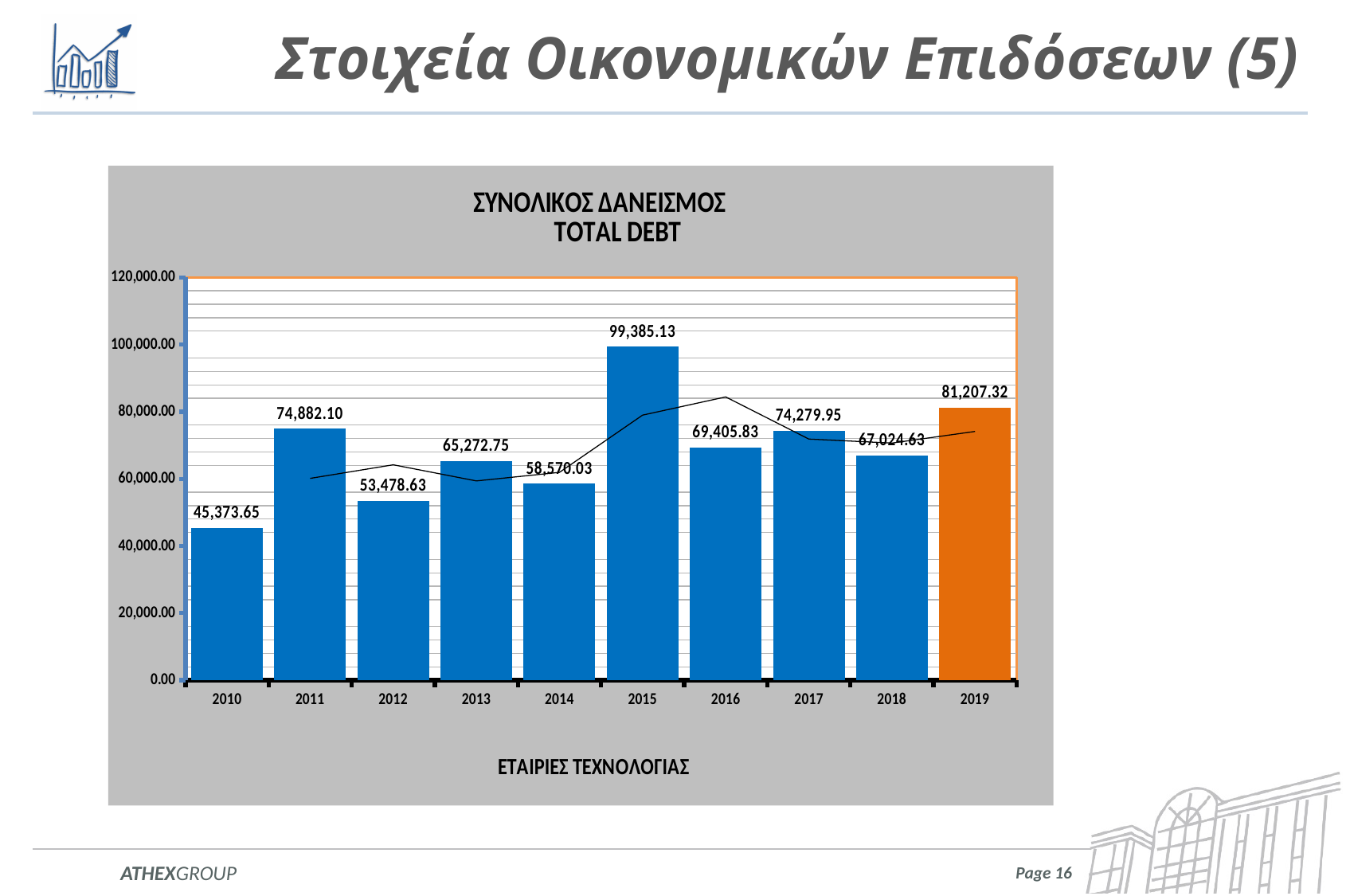
What is the total debt value for 2010? 45,373.65 How many years are shown on the x axis of the chart? 10 What is the difference between the total debt in 2015 and in 2010? 54,011.48 What kind of chart is used to show total debt? bar chart Which year has a larger total debt, 2011 or 2012? 2011 What is the difference between the total debt in 2019 and in 2018? 14,182.69 Is the total debt for 2016 greater or less than 60,000.00? greater What is the total debt value for 2019? 81,207.32 Does the total debt rise or fall from 2015 to 2016? fall Which year has the highest total debt? 2015 What is the total debt value for 2015? 99,385.13 Which year has the lowest total debt? 2010